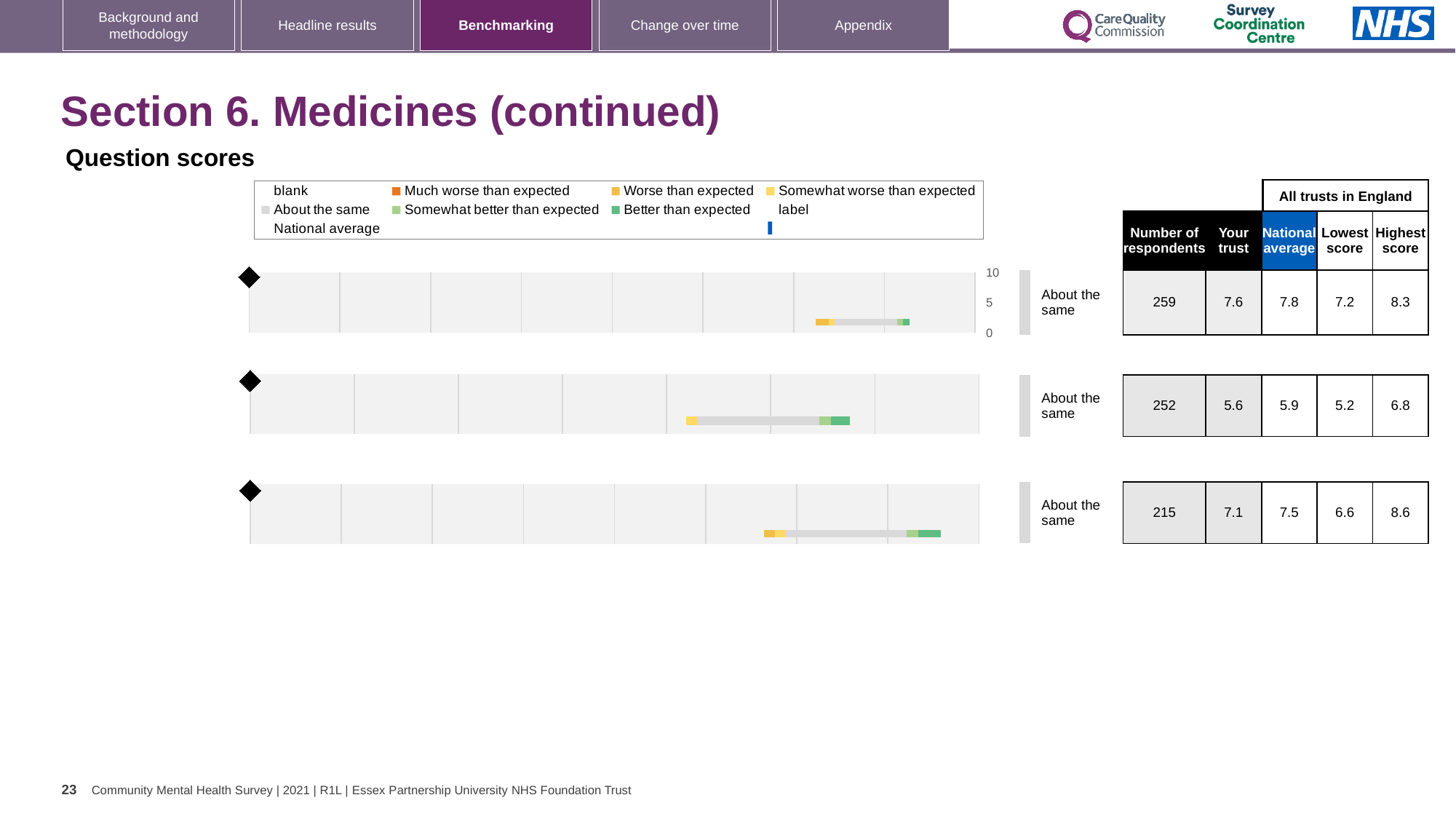
What kind of chart is used for the question scores on this slide? bar chart For the third (bottom) chart row, how many respondents are there? 215 For the second (middle) chart row, what is the lowest score among all trusts in England? 5.2 How many question score charts (rows) are shown on the slide? 3 For the second (middle) chart row, what is the national average score? 5.9 For the first (top) chart row, what is the 'Your trust' score? 7.6 For the first (top) chart row, which is larger: the 'Your trust' score or the national average? National average What benchmark category label is shown next to each of the three chart rows? About the same For the third (bottom) chart row, what is the difference between the highest score and the lowest score? 2.0 Which chart row has the highest 'Your trust' score? the first (top) row Which chart row has the lowest number of respondents? the third (bottom) row For the first (top) chart row, how much higher is the national average than the 'Your trust' score? 0.2